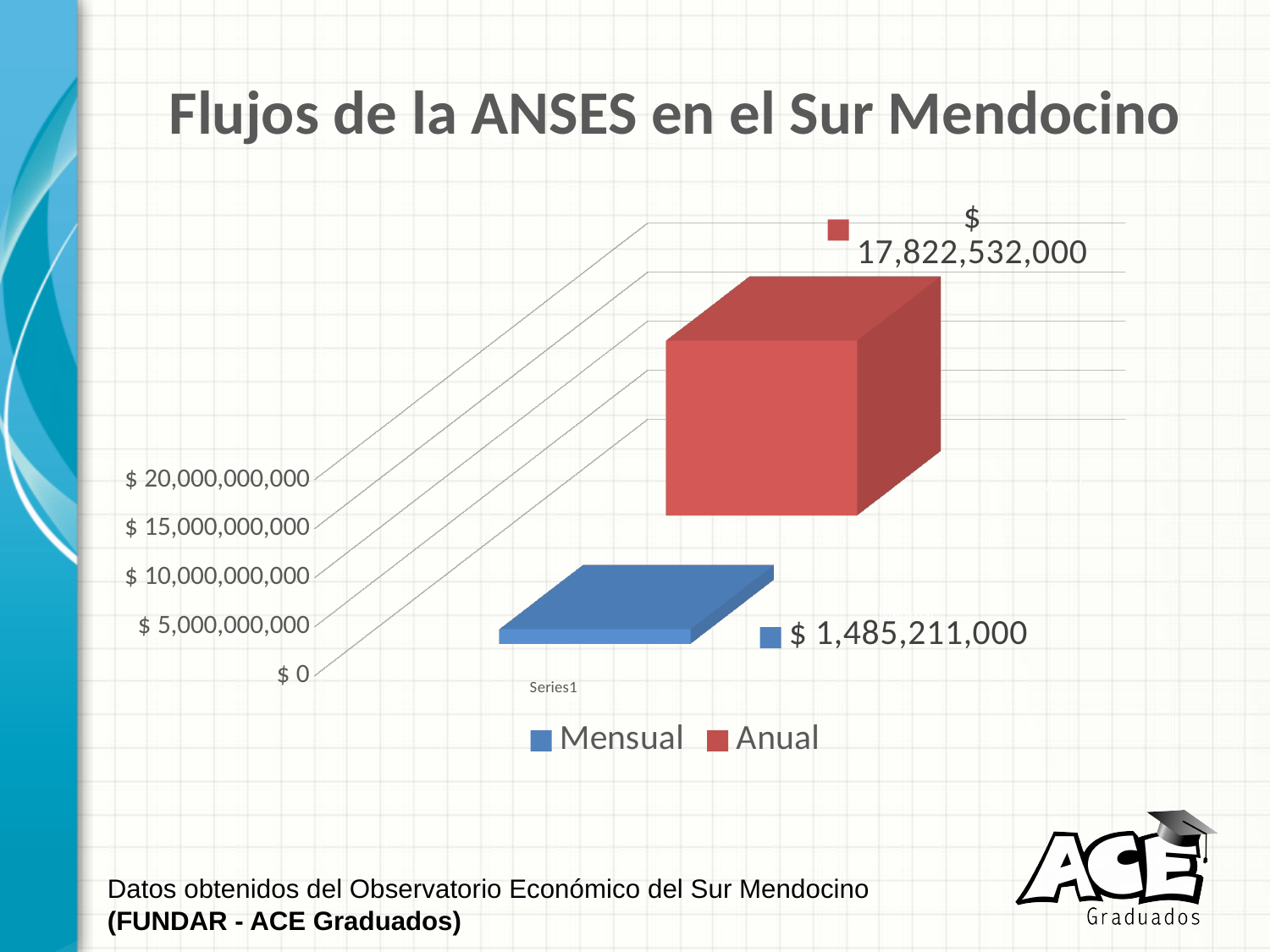
Which series has the lowest value? Mensual Which series has the higher value, Mensual or Anual? Anual What is the title of the chart? Flujos de la ANSES en el Sur Mendocino Is the value for Mensual greater or less than $ 5,000,000,000? less What is the value for Mensual? $ 1,485,211,000 What colour is the Anual series in the chart? Red What is the difference between the Anual and Mensual values? $ 16,337,321,000 Which series has the highest value? Anual Is the value for Anual greater or less than $ 15,000,000,000? greater What kind of chart is shown on the slide? Bar chart How many series does the legend list? 2 What is the value for Anual? $ 17,822,532,000